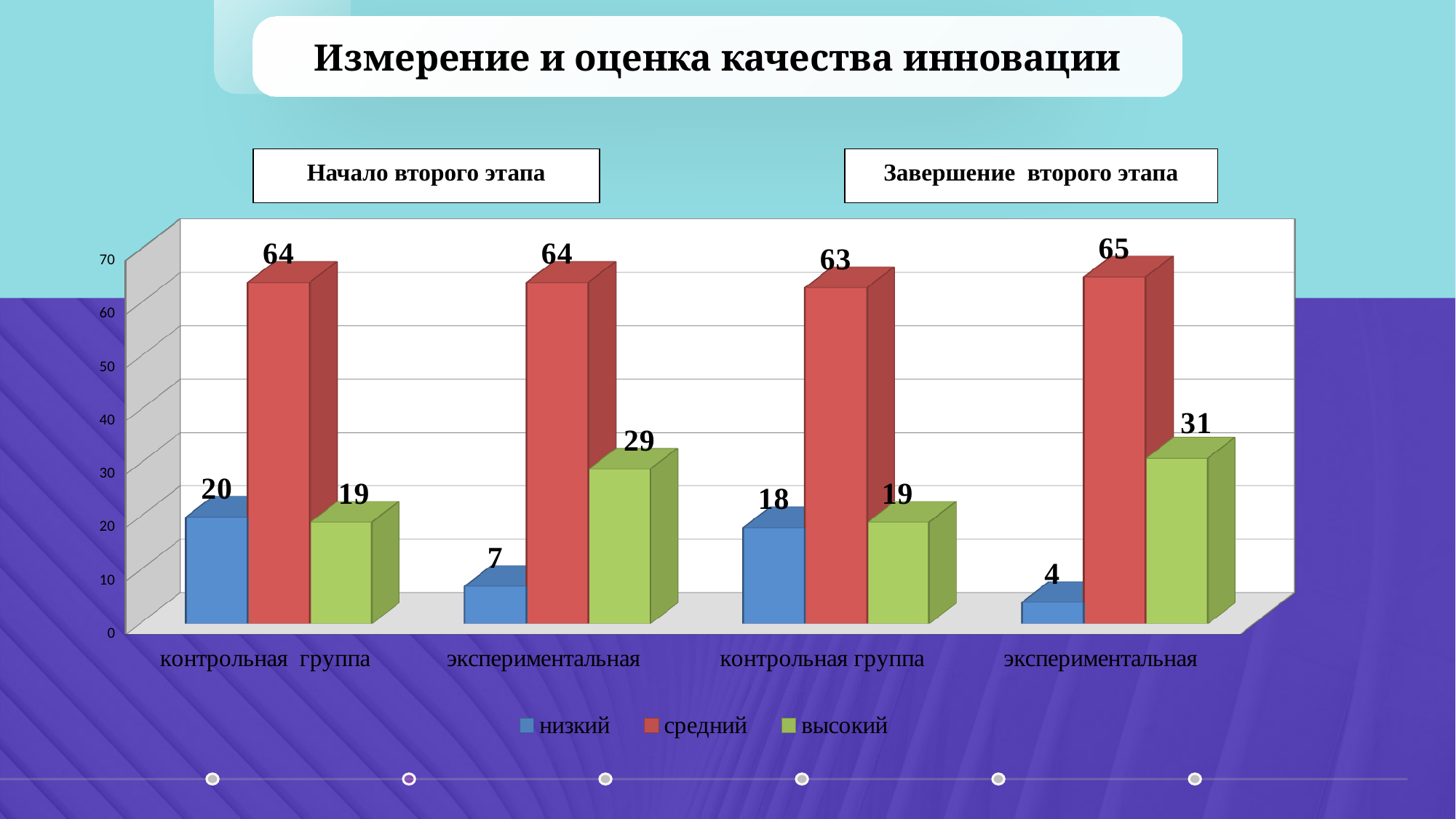
What is the value of 'низкий' for the экспериментальная group at the end of the second stage (Завершение второго этапа)? 4 What is the value of 'высокий' for the экспериментальная group at the start of the second stage (Начало второго этапа)? 29 Which series has the highest value for the экспериментальная group at the end of the second stage (Завершение второго этапа)? средний What type of chart is shown on the slide? bar chart What is the difference between the 'высокий' values for the экспериментальная group at the end (31) and at the start (29) of the second stage? 2 How many category groups are shown along the x axis? 4 Which series is shown in red in the legend? средний What is the value of 'низкий' for the контрольная группа at the end of the second stage (Завершение второго этапа)? 18 Which series has the lowest value for the экспериментальная group at the start of the second stage (Начало второго этапа)? низкий Which is larger: 'низкий' for the контрольная группа at the start of the second stage or 'низкий' for the экспериментальная group at the start of the second stage? контрольная группа How many series does the legend list? 3 What is the value of 'средний' for the контрольная группа at the start of the second stage (Начало второго этапа)? 64